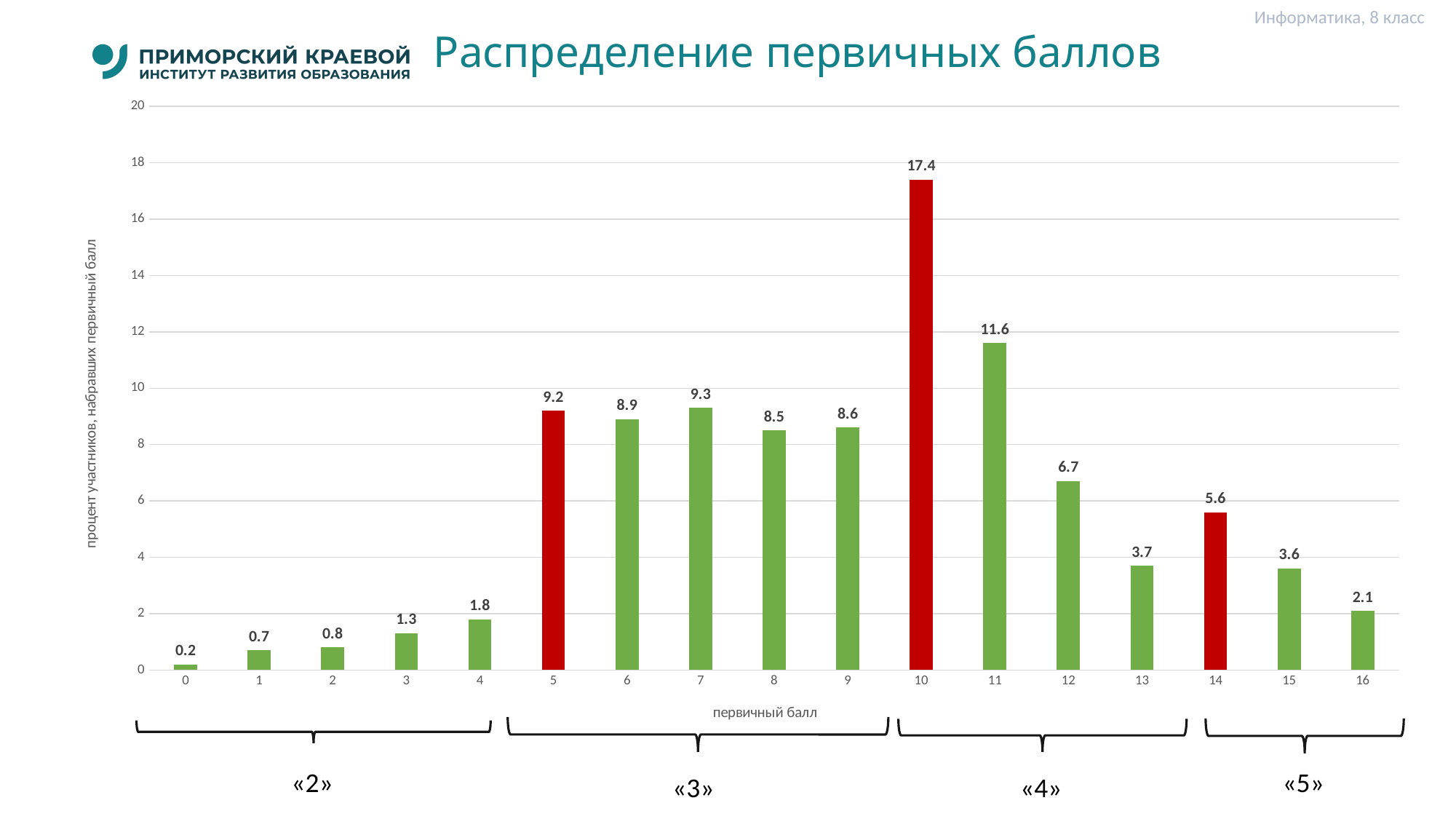
What is the title of the chart? Распределение первичных баллов Is the value for primary score 12 greater or less than 8? less What is the value for primary score 3? 1.3 Which primary score has the lowest value? 0 Do the values rise or fall from primary score 10 to primary score 13? fall What is the difference between the values for primary scores 10 and 11? 5.8 Which is larger, the value for primary score 5 or primary score 7? 7 What is the value for primary score 14? 5.6 What is the value for primary score 10? 17.4 Which primary score has the highest value? 10 What kind of chart is shown on the slide? bar chart How many primary score categories are shown on the x axis? 17